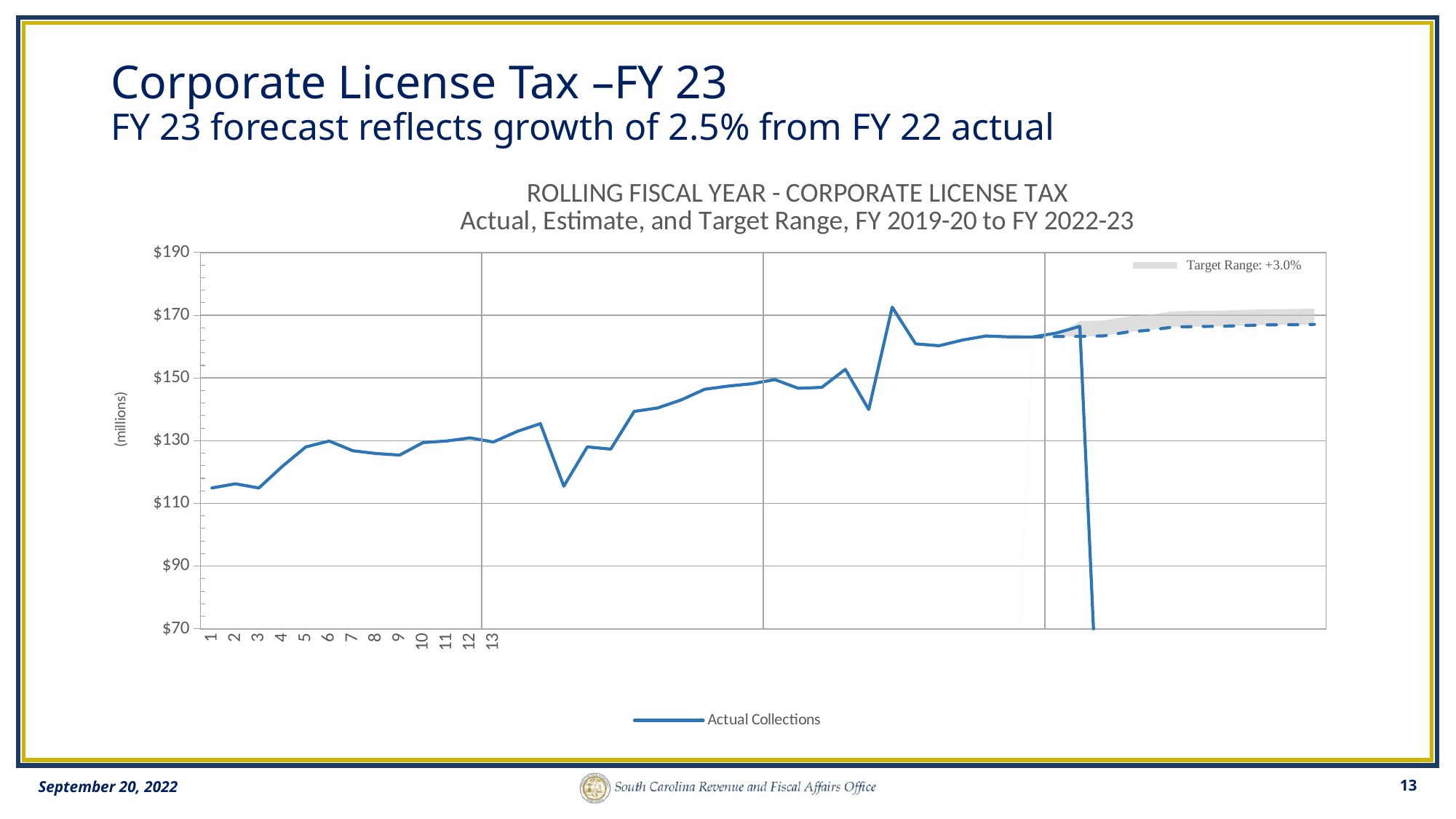
What is the title of the chart? ROLLING FISCAL YEAR - CORPORATE LICENSE TAX Actual, Estimate, and Target Range, FY 2019-20 to FY 2022-23 Is the value of Actual Collections at point 3 greater or less than $130? less What series name is shown in the legend at the bottom of the chart? Actual Collections Do the Actual Collections values generally rise or fall from left to right across the chart? rise Is the highest peak of the Actual Collections line greater or less than $150? greater Is the value of Actual Collections at point 1 greater or less than $110? greater What is the lowest value shown on the y-axis? $70 What kind of chart is shown on the slide? line chart